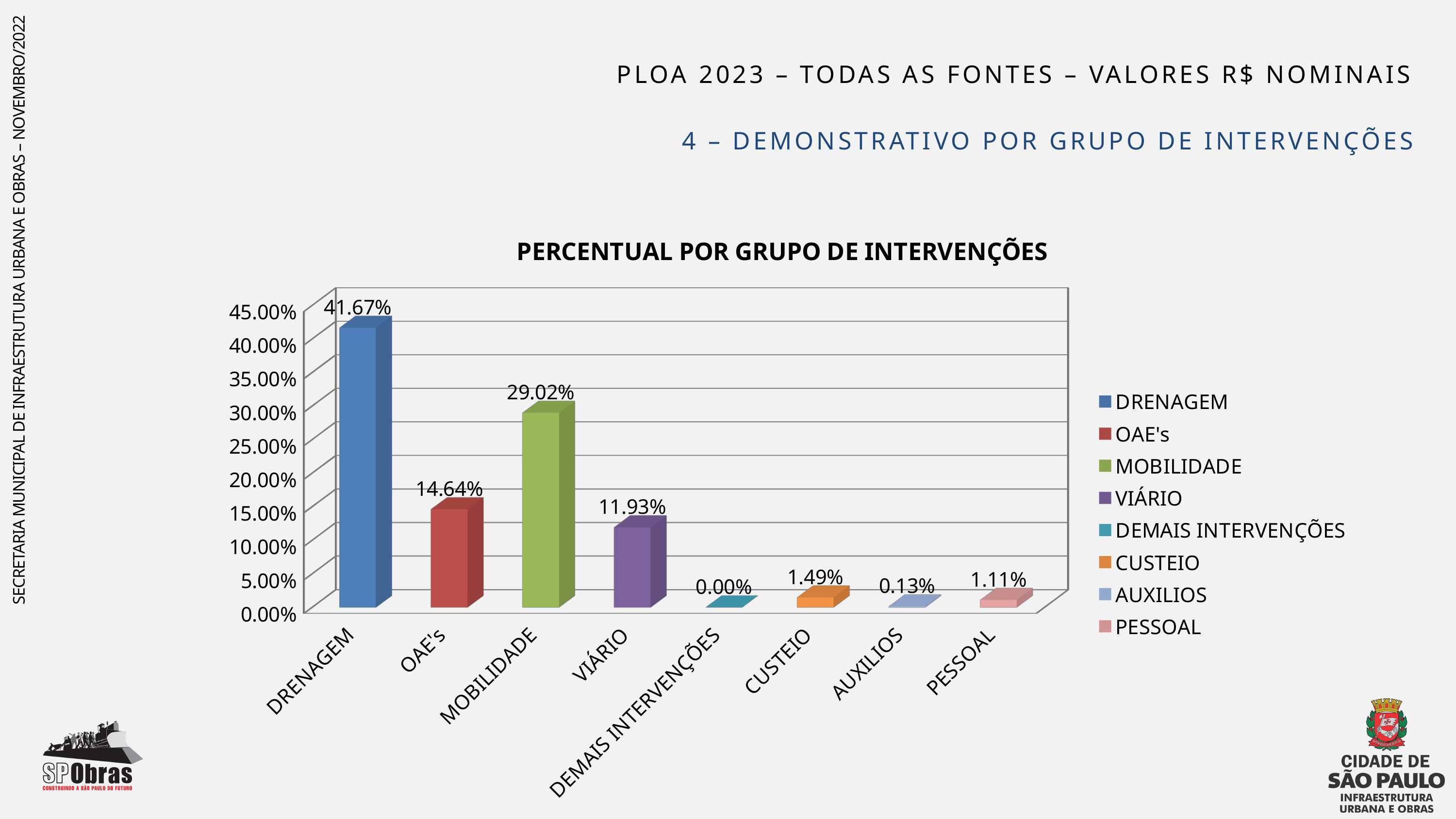
Which category has the highest value? DRENAGEM Is the value for OAE's greater or less than 10.00%? greater Which is larger, the value for OAE's or the value for VIÁRIO? OAE's What is the difference between the values for DRENAGEM and MOBILIDADE? 12.65% What is the value for DEMAIS INTERVENÇÕES? 0.00% Which category has the lowest value? DEMAIS INTERVENÇÕES What is the value for AUXILIOS? 0.13% What kind of chart is shown? bar chart What is the value for MOBILIDADE? 29.02% What is the value for DRENAGEM? 41.67% How many categories are shown on the x axis? 8 What is the title of the chart? PERCENTUAL POR GRUPO DE INTERVENÇÕES